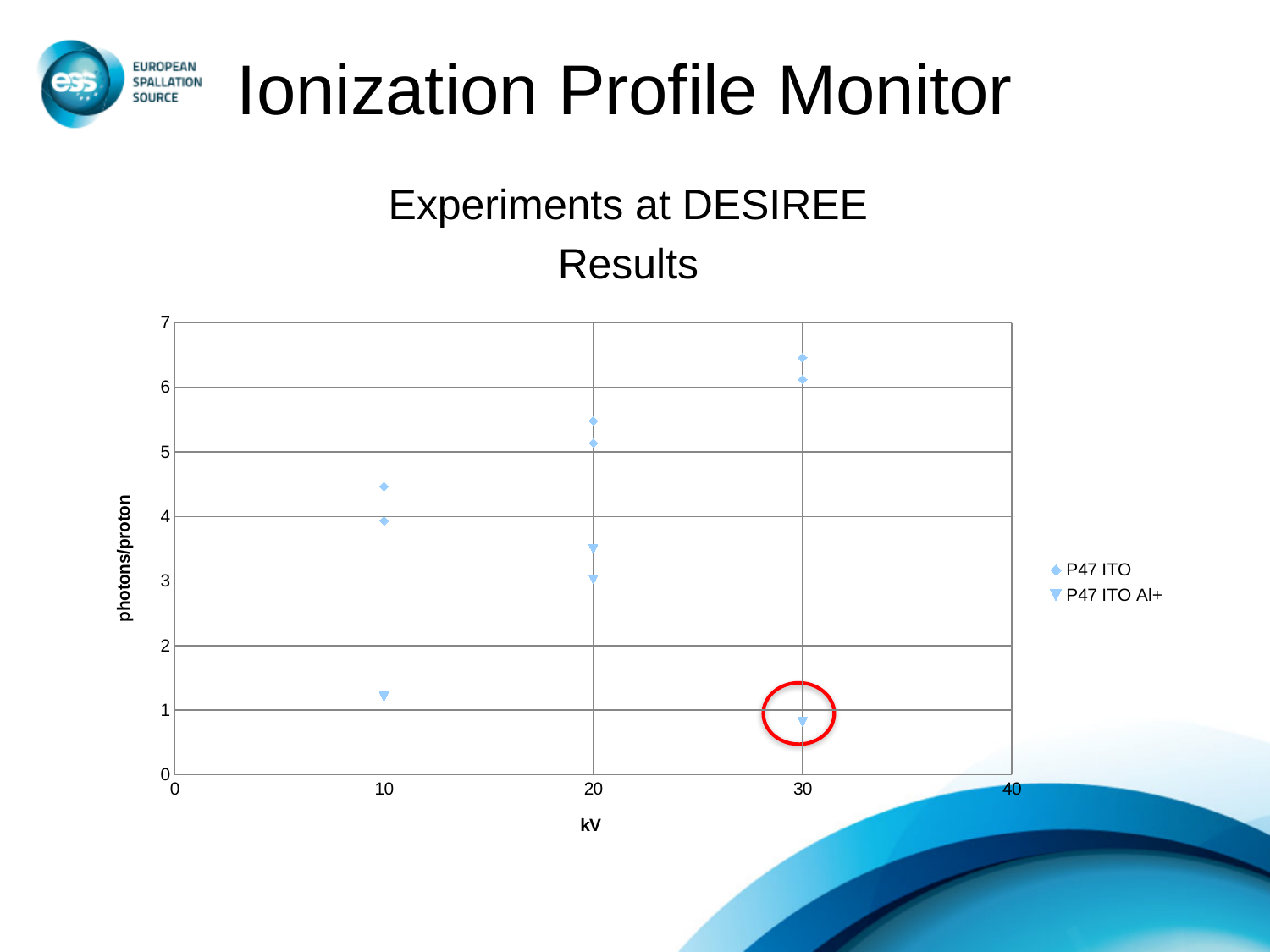
Is the P47 ITO Al+ value at 30 kV greater or less than 1? less What kind of chart is shown on the slide? scatter chart At which kV value does the P47 ITO Al+ series have its lowest photons/proton? 30 At 30 kV, which series has the higher photons/proton value, P47 ITO or P47 ITO Al+? P47 ITO Are the P47 ITO values at 20 kV greater or less than 5? greater Do the P47 ITO values rise or fall as kV increases from 10 to 30? rise Is the P47 ITO Al+ value at 10 kV greater or less than 2? less What is the label of the y axis? photons/proton What are the two series named in the legend? P47 ITO and P47 ITO Al+ How many series does the legend list? 2 At which kV value does the P47 ITO series reach its highest photons/proton? 30